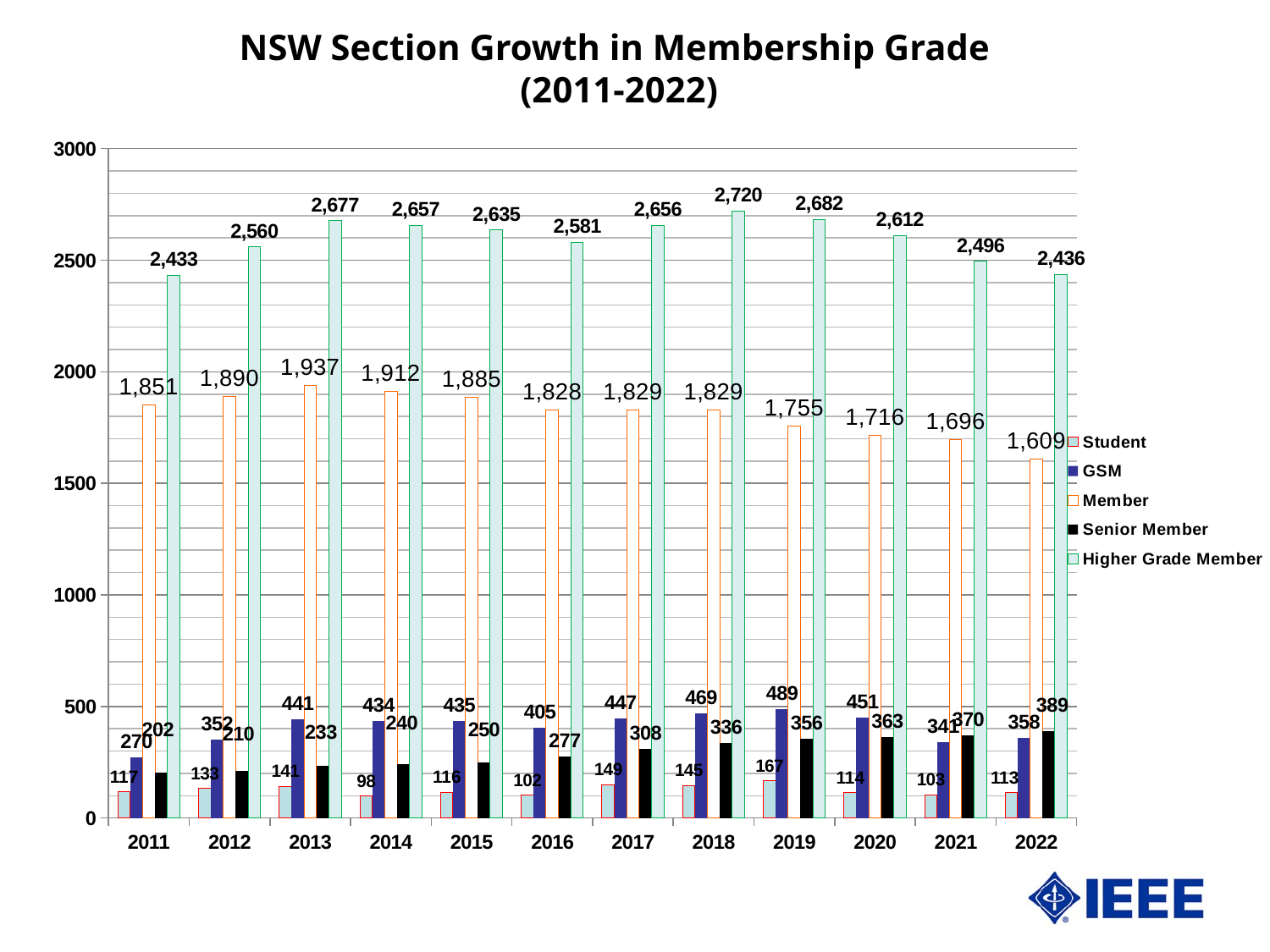
What is the GSM value for 2019? 489 How many years are shown on the x axis? 12 What is the difference between the Member values for 2013 and 2022? 328 What is the Higher Grade Member value for 2018? 2,720 What is the Member value for 2022? 1,609 Which year has the highest Higher Grade Member value? 2018 Which year has the lowest Student value? 2014 Which is larger, the GSM value for 2012 or the GSM value for 2021? 2012 Do the Senior Member values rise or fall from 2011 to 2022? Rise What is the Senior Member value for 2011? 202 What kind of chart is shown on the slide? Bar chart How many series does the legend list? 5